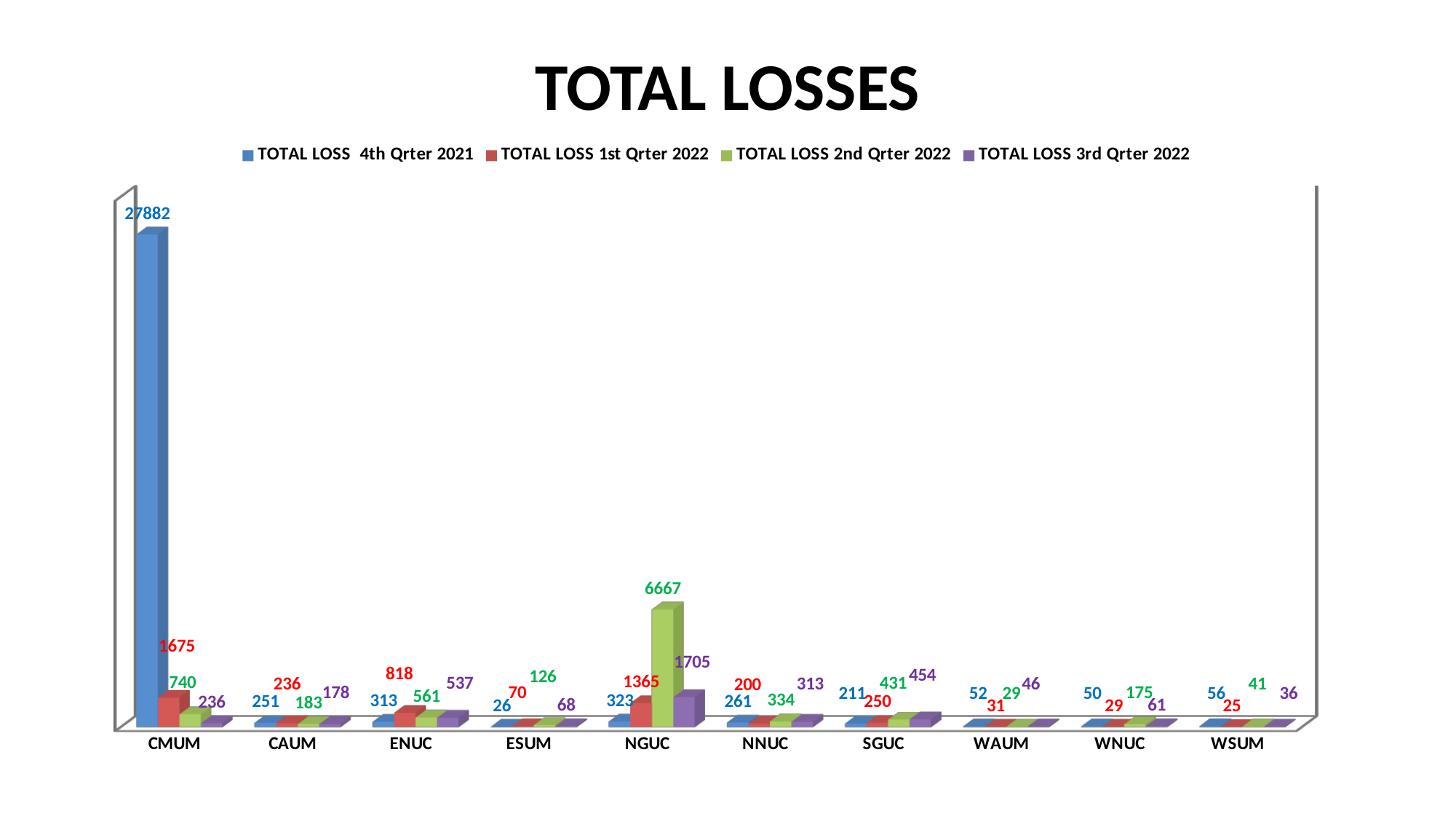
What is the difference between the TOTAL LOSS 3rd Qrter 2022 value for NGUC and the TOTAL LOSS 1st Qrter 2022 value for NGUC? 340 What is the title of the chart? TOTAL LOSSES Which category has the lowest TOTAL LOSS 4th Qrter 2021 value? ESUM Which is larger for WNUC: the TOTAL LOSS 2nd Qrter 2022 value or the TOTAL LOSS 3rd Qrter 2022 value? TOTAL LOSS 2nd Qrter 2022 What is the TOTAL LOSS 3rd Qrter 2022 value for SGUC? 454 What kind of chart is shown on the slide? Bar chart Which category has the highest TOTAL LOSS 2nd Qrter 2022 value? NGUC How many series does the legend list? 4 What is the TOTAL LOSS 1st Qrter 2022 value for ENUC? 818 What is the TOTAL LOSS 2nd Qrter 2022 value for NGUC? 6667 How many categories are shown on the x axis? 10 What is the TOTAL LOSS 4th Qrter 2021 value for CMUM? 27882